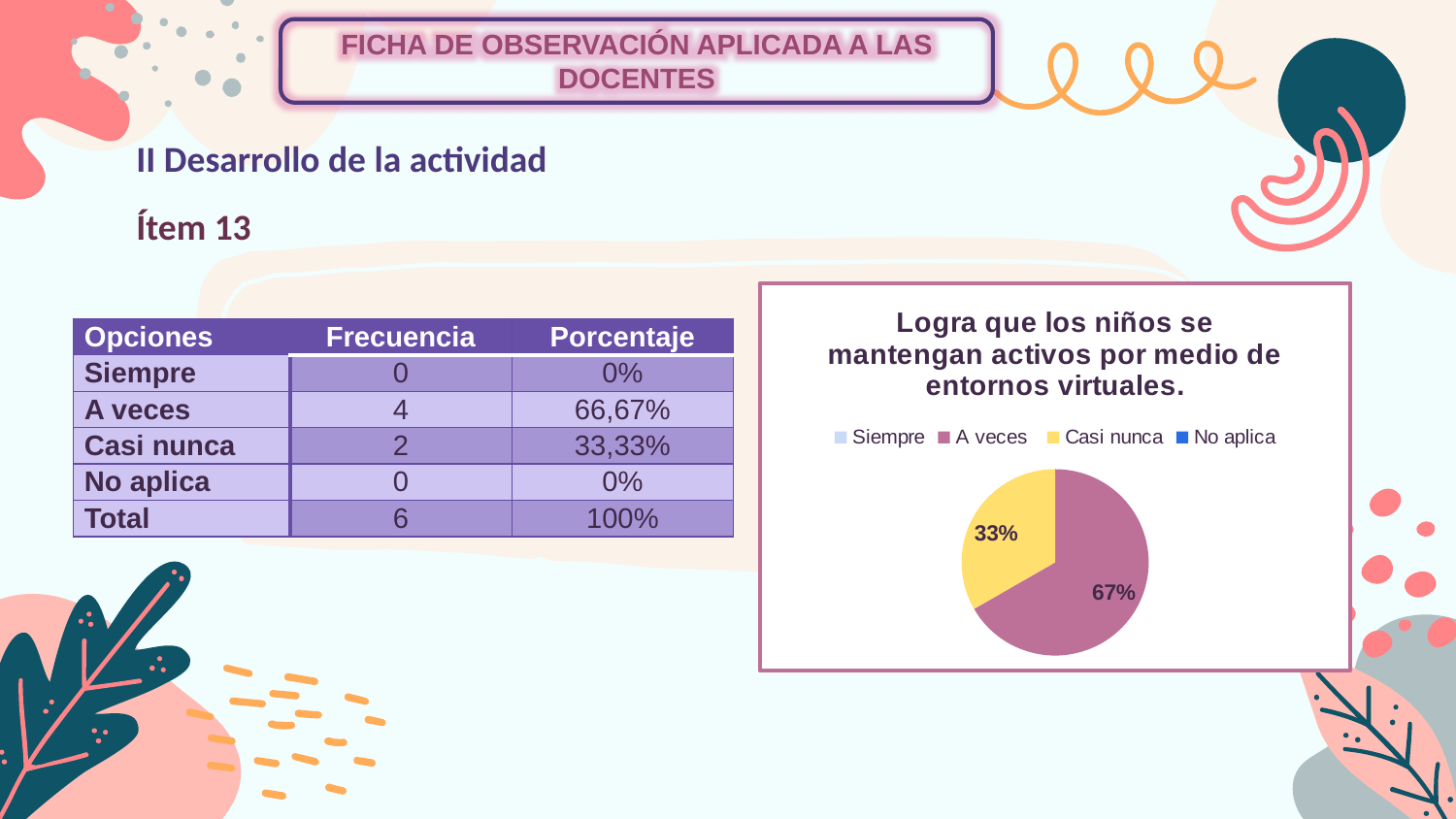
Which is larger in the pie chart, "A veces" or "Casi nunca"? A veces Which category has the largest slice in the pie chart? A veces What kind of chart is shown on the slide? pie chart How many entries does the pie chart's legend list? 4 What percentage does the pie chart show for "A veces"? 67% What is the title of the pie chart? Logra que los niños se mantengan activos por medio de entornos virtuales. What percentage does the pie chart show for "Casi nunca"? 33% What is the difference in percentage points between the "A veces" and "Casi nunca" slices in the pie chart? 34 How many slices are visible in the pie chart? 2 What colour is the "Casi nunca" slice in the pie chart? yellow Is the value for "A veces" in the pie chart greater or less than 50%? greater Which legend entry is listed first in the pie chart's legend? Siempre